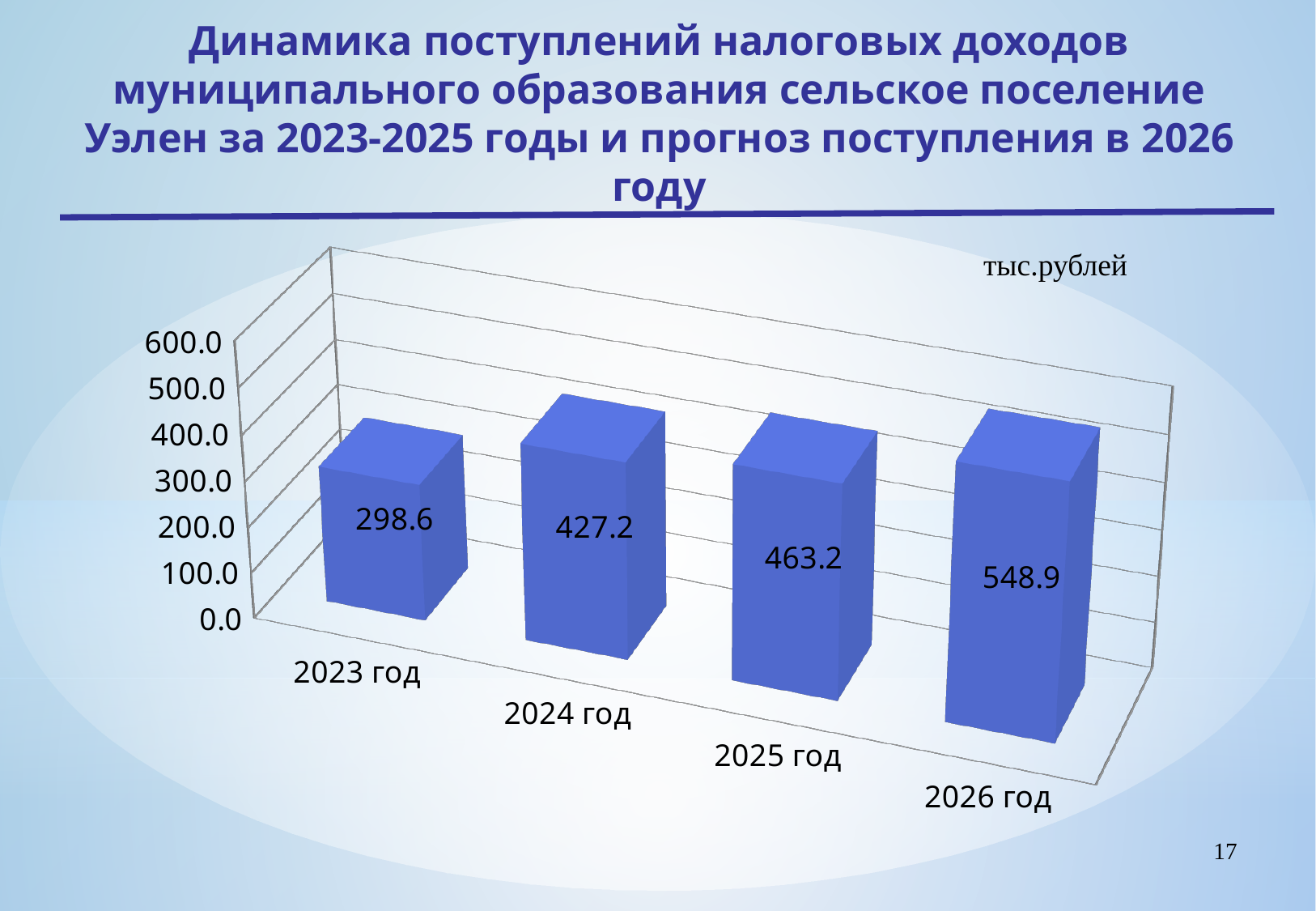
What is the difference between the values for 2026 год and 2023 год? 250.3 What is the value for 2025 год? 463.2 How many years are shown on the chart? 4 What is the value for 2026 год? 548.9 Which year has the highest value? 2026 год What kind of chart is this? bar chart What is the difference between the values for 2025 год and 2024 год? 36.0 Which year has the lowest value? 2023 год What is the value for 2024 год? 427.2 Do the values rise or fall from 2023 год to 2026 год? rise What is the value for 2023 год? 298.6 Which is larger, the value for 2024 год or the value for 2025 год? 2025 год